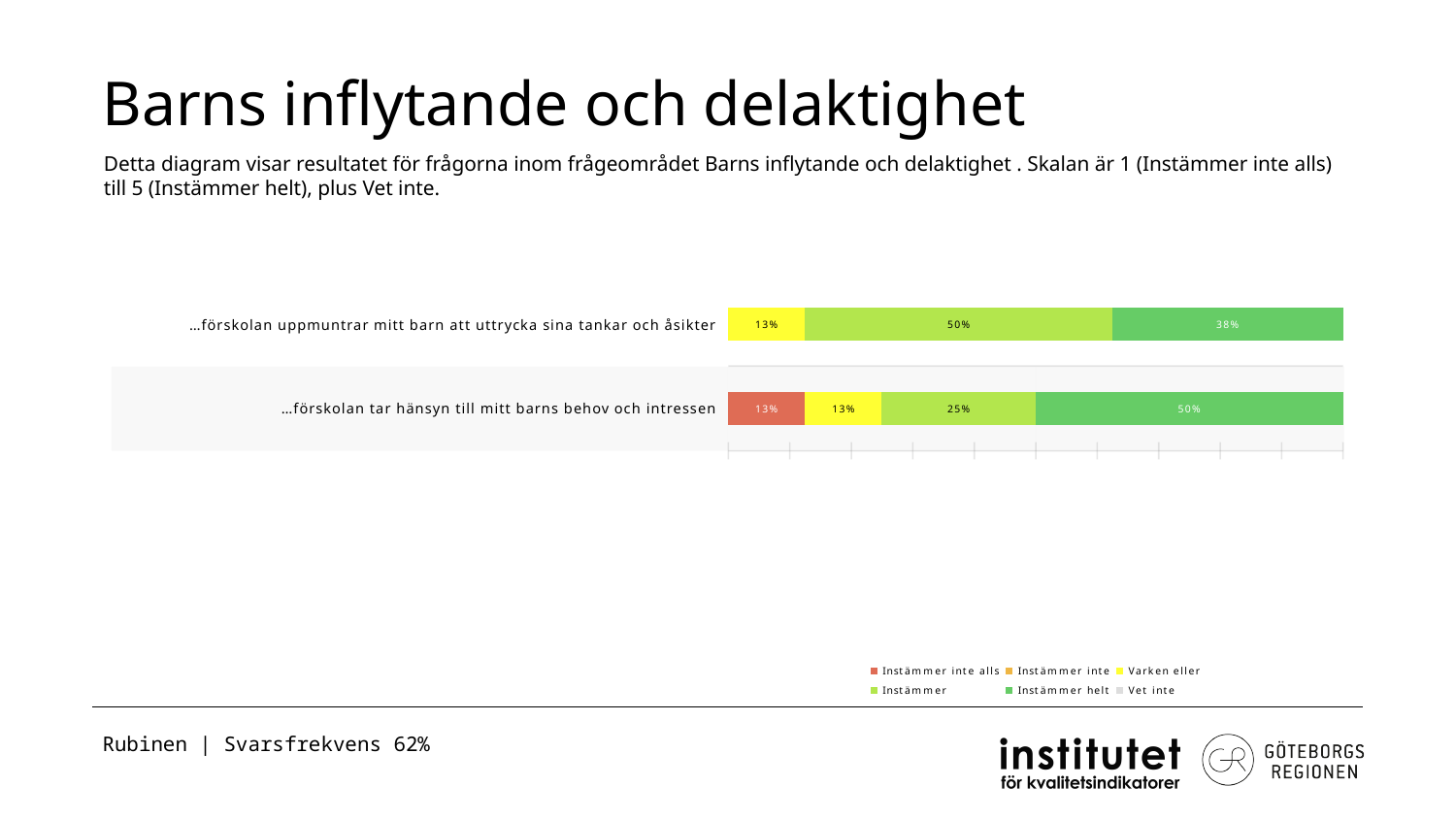
What is the difference in the 'Instämmer helt' share between '…förskolan tar hänsyn till mitt barns behov och intressen' and '…förskolan uppmuntrar mitt barn att uttrycka sina tankar och åsikter'? 12% How many questions (categories) are plotted in the chart? 2 Which question has the larger 'Instämmer helt' share? …förskolan tar hänsyn till mitt barns behov och intressen How many series does the legend list? 6 Which legend entry is shown in grey? Vet inte What is the 'Instämmer helt' share for '…förskolan tar hänsyn till mitt barns behov och intressen'? 50% What kind of chart is shown on the slide? Stacked bar chart What is the 'Instämmer inte alls' share for '…förskolan tar hänsyn till mitt barns behov och intressen'? 13% What is the 'Instämmer' share for '…förskolan tar hänsyn till mitt barns behov och intressen'? 25% What is the 'Instämmer' share for '…förskolan uppmuntrar mitt barn att uttrycka sina tankar och åsikter'? 50% What is the 'Instämmer helt' share for '…förskolan uppmuntrar mitt barn att uttrycka sina tankar och åsikter'? 38% What is the difference in the 'Instämmer' share between '…förskolan uppmuntrar mitt barn att uttrycka sina tankar och åsikter' and '…förskolan tar hänsyn till mitt barns behov och intressen'? 25%